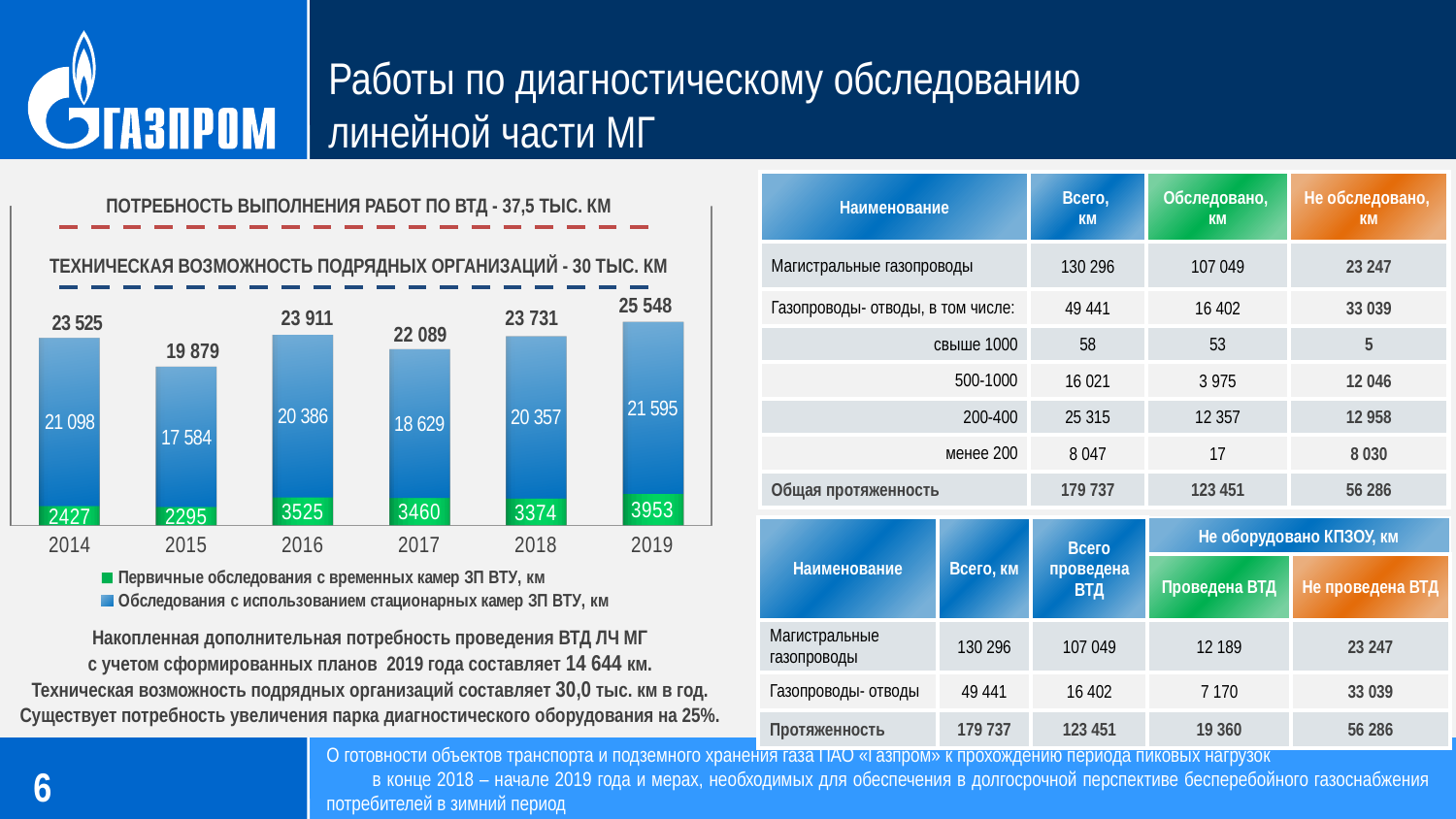
What is the difference between the totals for 2019 and 2018? 1 817 Which year has the lowest total in the bar chart? 2015 Which is larger: the value of 'Обследования с использованием стационарных камер ЗП ВТУ, км' in 2014 or in 2017? 2014 What is the value of 'Обследования с использованием стационарных камер ЗП ВТУ, км' for 2015? 17 584 What colour represents 'Первичные обследования с временных камер ЗП ВТУ, км' in the bar chart? green What is the value of 'Первичные обследования с временных камер ЗП ВТУ, км' for 2019? 3953 What type of chart is shown on the slide? stacked bar chart Which year has the highest total in the bar chart? 2019 How many series does the legend of the bar chart list? 2 How many years are shown on the x axis of the bar chart? 6 What is the total value of the stacked bar for 2019? 25 548 What is the value of 'Первичные обследования с временных камер ЗП ВТУ, км' for 2016? 3525